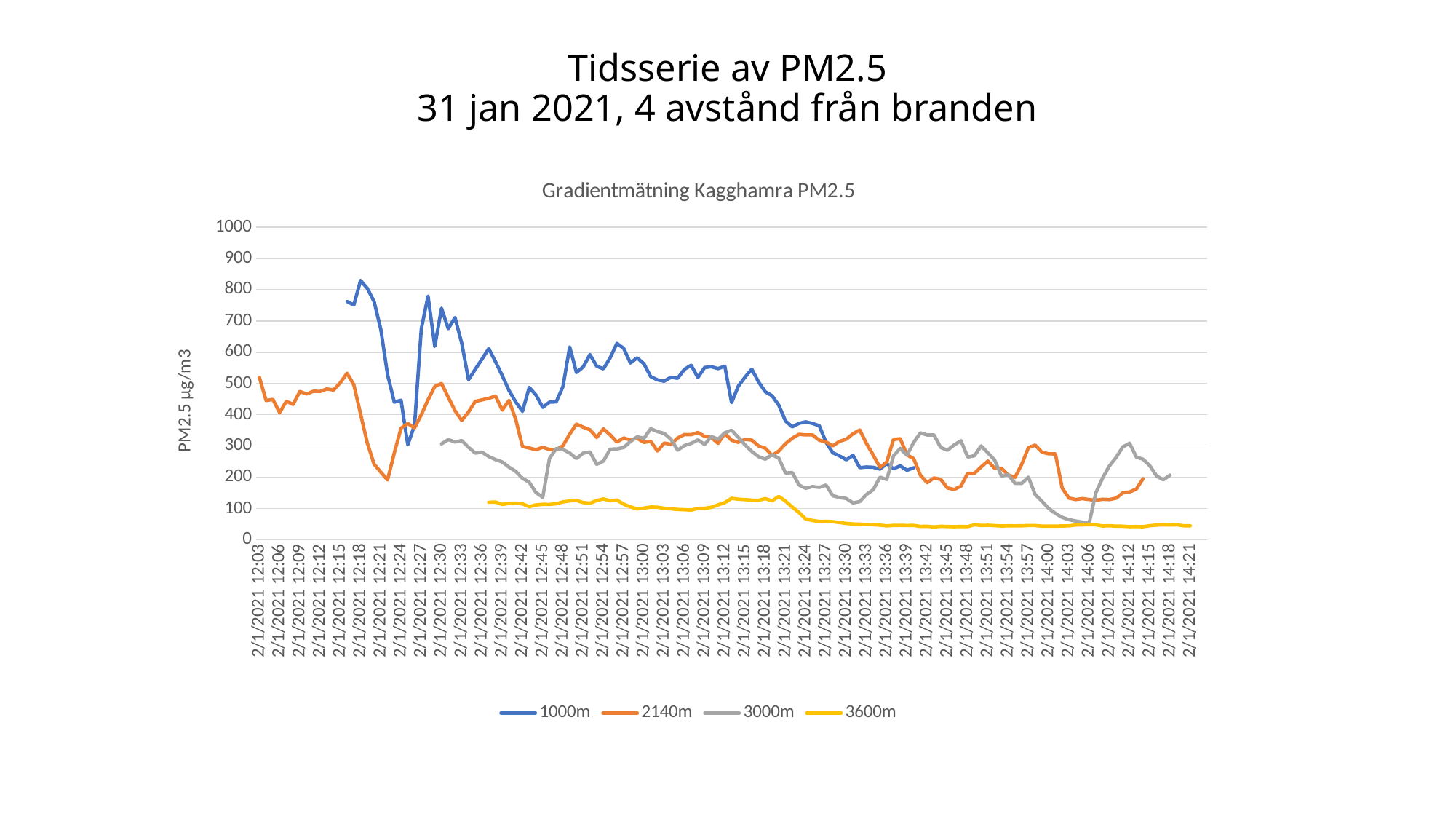
Which series has the lowest values throughout the chart? 3600m How many series does the legend list? 4 Is the value of the 3000m series at 2/1/2021 12:45 greater or less than 200? less Does the 3600m series generally rise or fall over time along the x axis? fall What is the title of the chart? Gradientmätning Kagghamra PM2.5 Is the peak value of the 1000m series greater or less than 700? greater Around 2/1/2021 12:18, which series has the higher value, 1000m or 2140m? 1000m Does the 1000m series generally rise or fall over time along the x axis? fall What kind of chart is shown on the slide? line chart Is the value of the 3600m series at 2/1/2021 14:21 greater or less than 100? less What is the label on the vertical axis? PM2.5 µg/m3